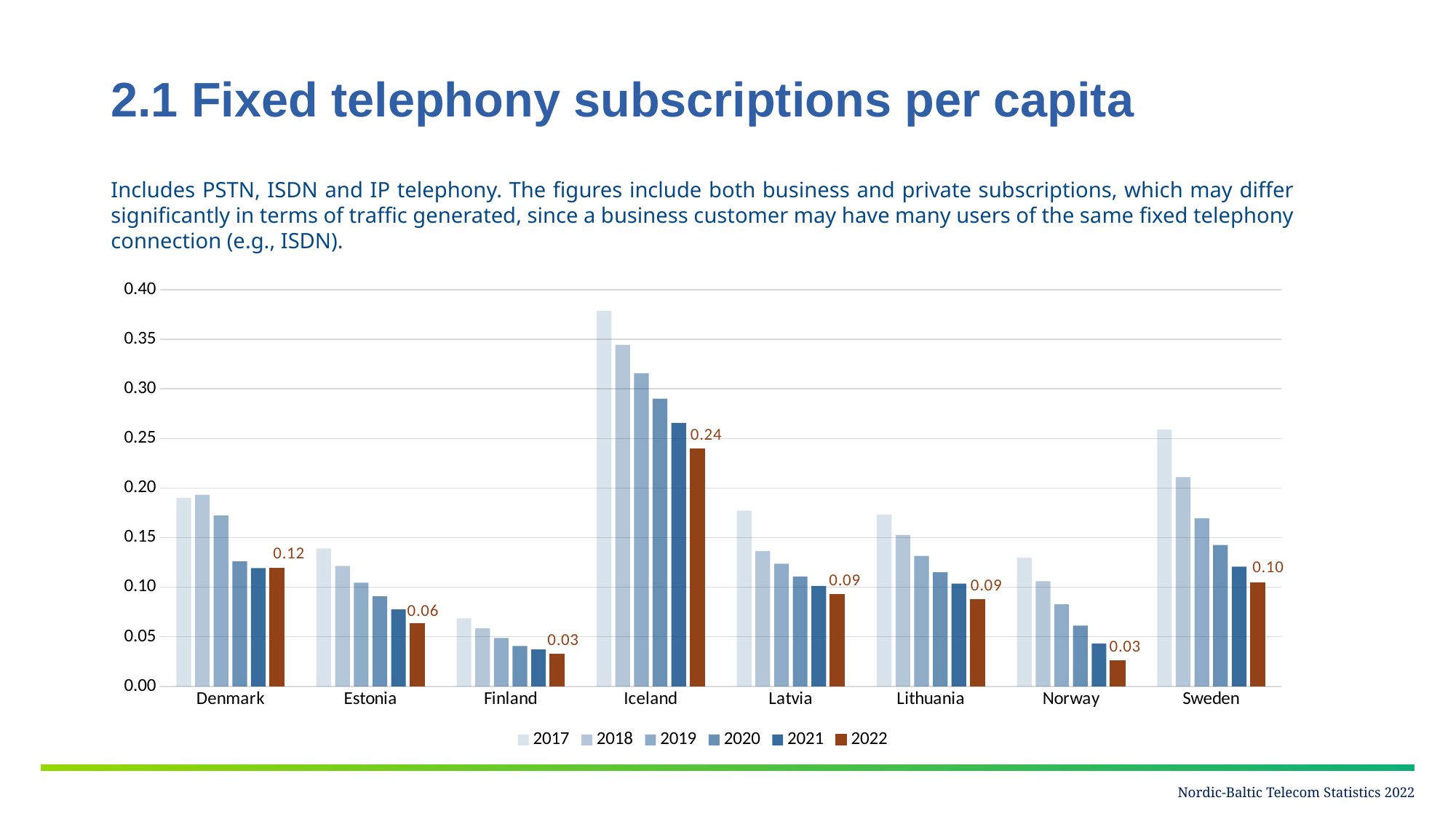
Which is larger, the 2022 value for Denmark or the 2022 value for Sweden? Denmark Is the 2017 value for Iceland greater or less than 0.35? greater Which country has the highest 2017 value? Iceland How many series does the legend list? 6 What is the 2022 value for Sweden? 0.10 What is the difference between the 2022 values for Iceland and Denmark? 0.12 Is the 2017 value for Finland greater or less than 0.10? less Which country has the highest 2022 value? Iceland What is the 2022 value for Estonia? 0.06 Do the values for Iceland rise or fall from 2017 to 2022? fall How many countries are shown on the x axis? 8 What is the 2022 value for Iceland? 0.24